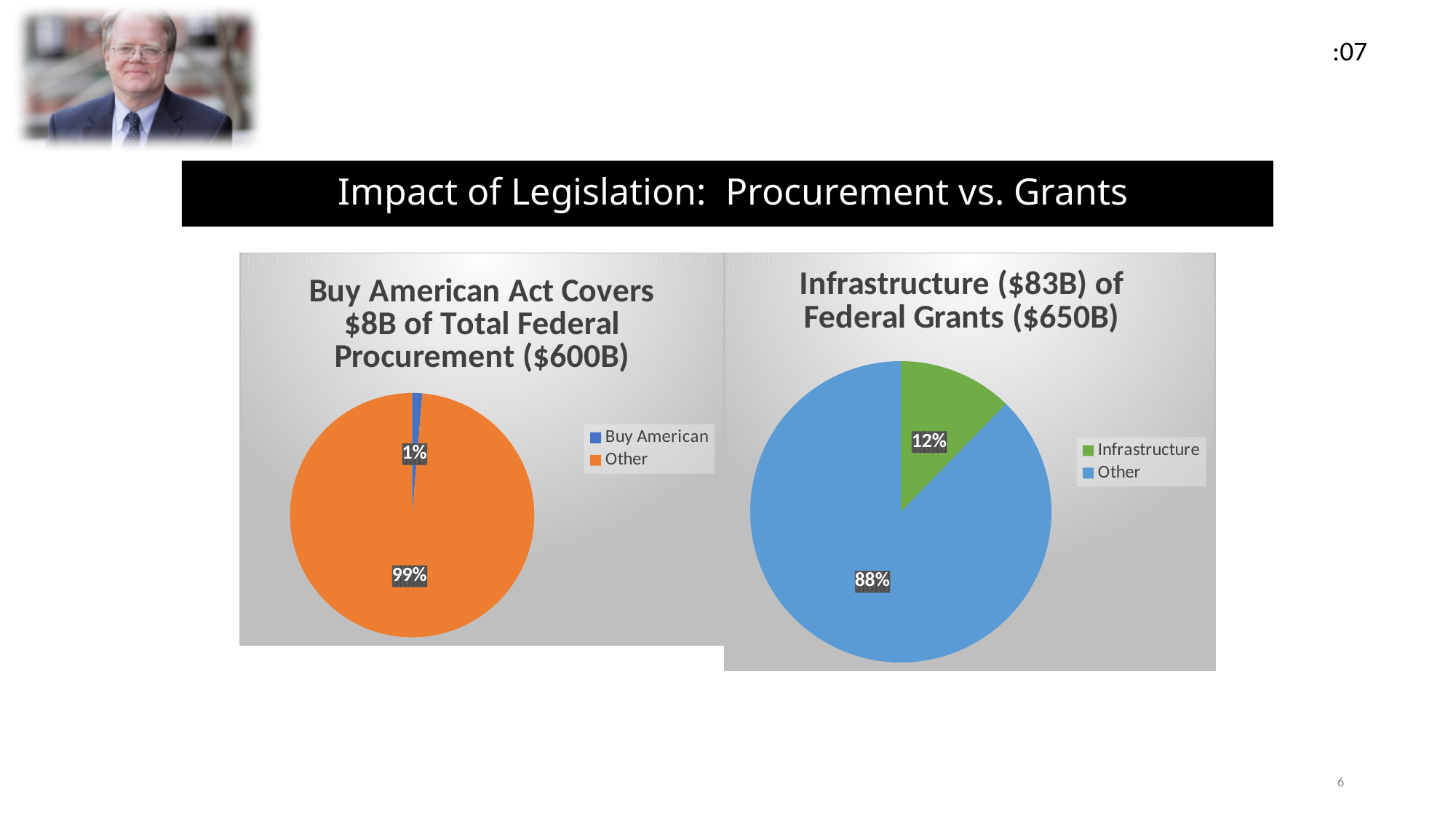
In the left chart (Buy American Act Covers $8B of Total Federal Procurement ($600B)), what share of the pie is Other? 99% In the right chart (Infrastructure ($83B) of Federal Grants ($650B)), what share of the pie is Infrastructure? 12% In the left chart, which slice is the largest? Other How many entries does the legend of the right chart list? 2 Which is larger: the Infrastructure share in the right chart or the Buy American share in the left chart? Infrastructure In the left chart (Buy American Act Covers $8B of Total Federal Procurement ($600B)), what share of the pie is Buy American? 1% In the right chart, what is the difference in percentage points between the Other slice and the Infrastructure slice? 76 What kind of chart is the left chart on the slide? Pie chart What colour is the Buy American slice in the left chart? Blue In the right chart, which slice is the smallest? Infrastructure What kind of chart is the right chart on the slide? Pie chart